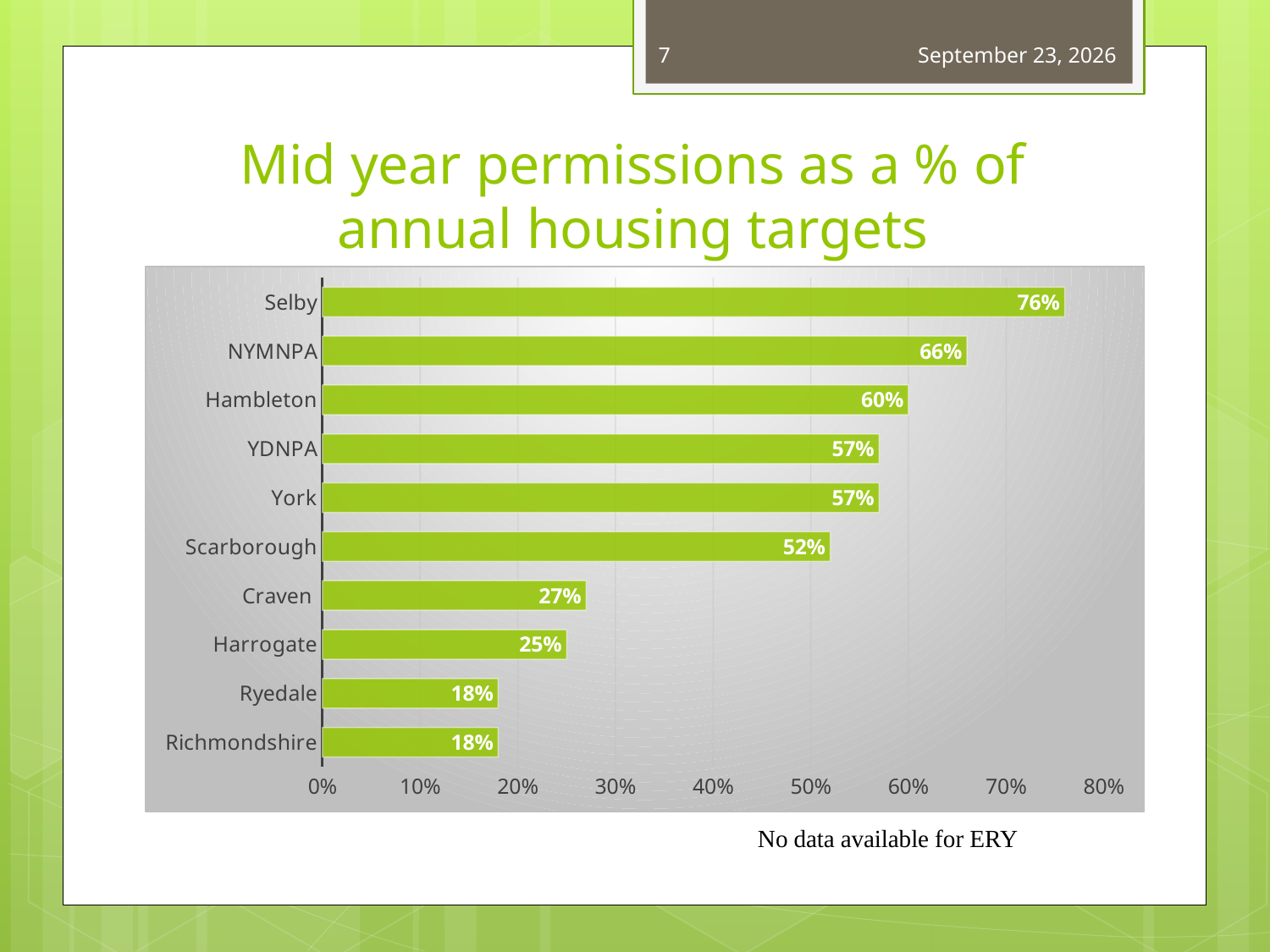
Which is larger, the value for Scarborough or the value for Craven? Scarborough What is the difference between the values for Selby and NYMNPA? 10% What is the value for Selby? 76% Is the value for Hambleton greater or less than 50%? greater What is the difference between the values for Hambleton and Craven? 33% What kind of chart is shown on the slide? Bar chart What is the title of the chart? Mid year permissions as a % of annual housing targets What is the value for Harrogate? 25% How many categories are shown in the chart? 10 Which two categories share the lowest value of 18%? Ryedale and Richmondshire Which category has the highest value? Selby What is the value for Scarborough? 52%